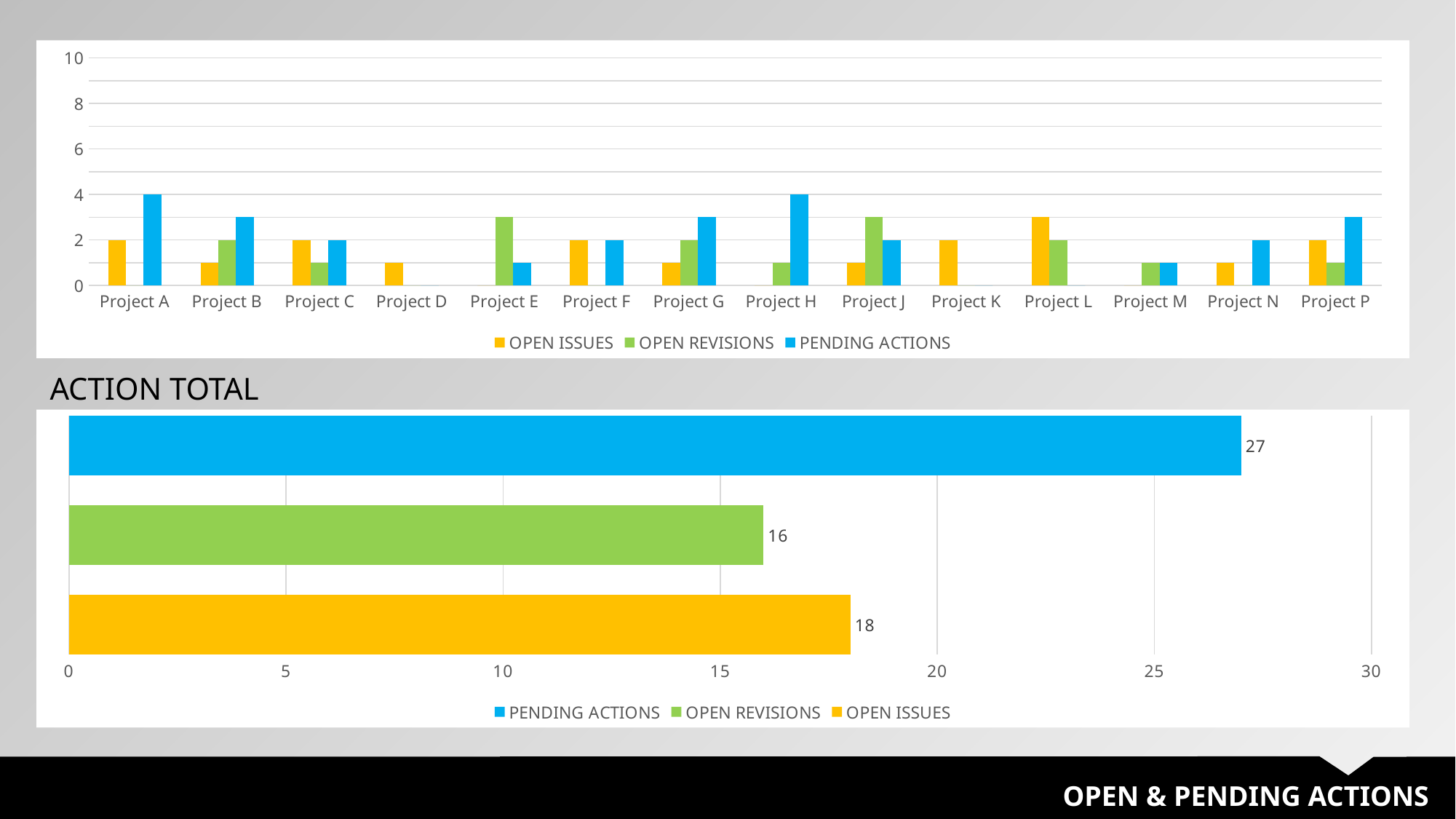
In the ACTION TOTAL chart, which category has the lowest value? OPEN REVISIONS In the ACTION TOTAL chart, which category has the highest value? PENDING ACTIONS In the top chart, how many projects are shown on the x axis? 14 What kind of chart is the ACTION TOTAL chart? Bar chart In the ACTION TOTAL chart, what is the value for OPEN REVISIONS? 16 In the ACTION TOTAL chart, which is larger, OPEN ISSUES or OPEN REVISIONS? OPEN ISSUES In the top chart, what is the PENDING ACTIONS value for Project A? 4 In the ACTION TOTAL chart, what is the value for OPEN ISSUES? 18 In the ACTION TOTAL chart, what is the value for PENDING ACTIONS? 27 In the ACTION TOTAL chart, what is the difference between PENDING ACTIONS and OPEN ISSUES? 9 In the top chart, how many series does the legend list? 3 In the top chart, what is the PENDING ACTIONS value for Project H? 4